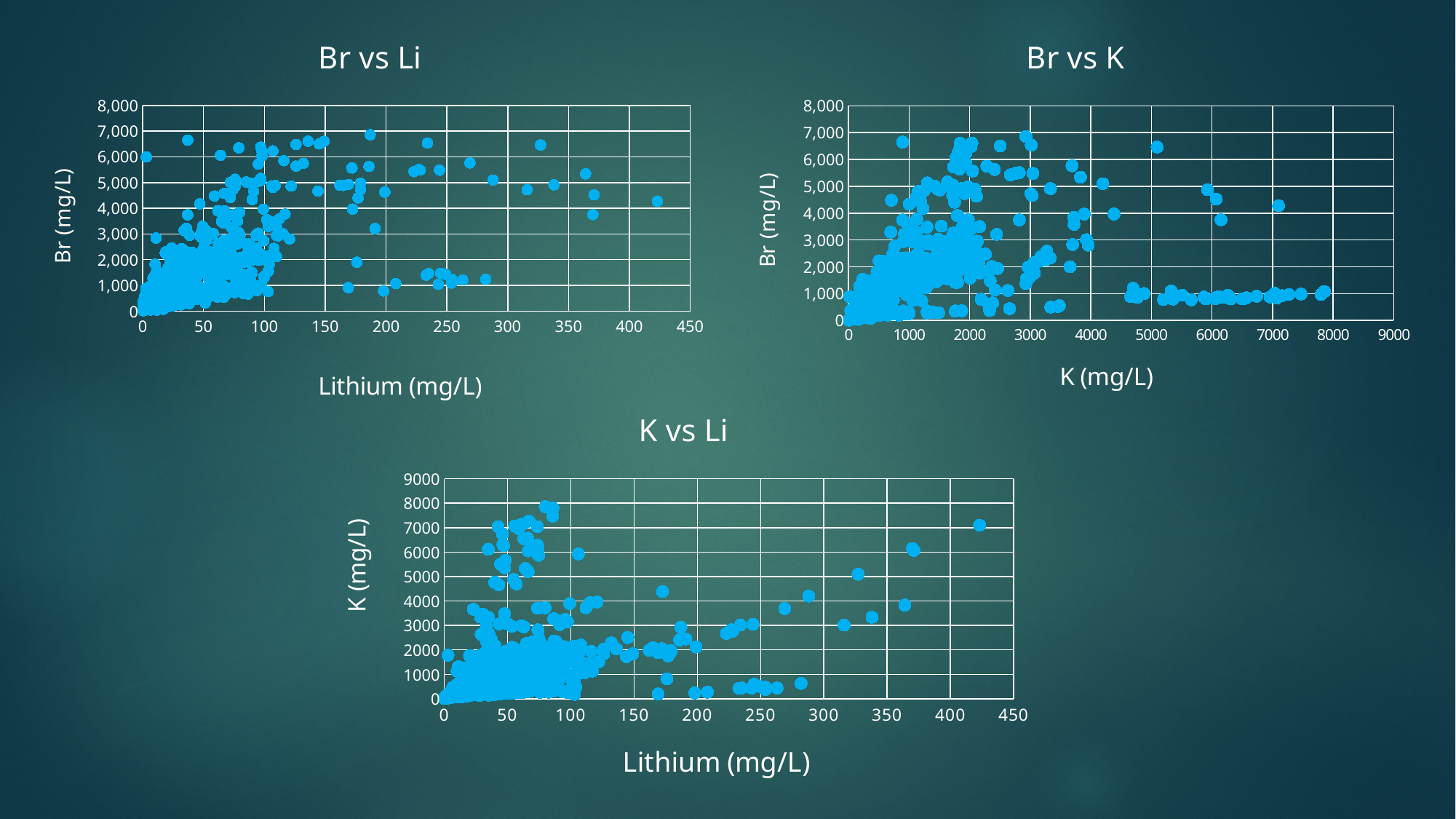
In the "Br vs K" chart, is the highest Br value plotted greater or less than 8,000? less What is the y-axis label of the "K vs Li" chart? K (mg/L) What is the x-axis label of the "Br vs K" chart? K (mg/L) In the "Br vs K" chart, is the largest K value plotted greater or less than 7000? greater What kind of chart is the "Br vs Li" chart? Scatter chart In the "Br vs Li" chart, is the largest lithium value plotted greater or less than 400? greater